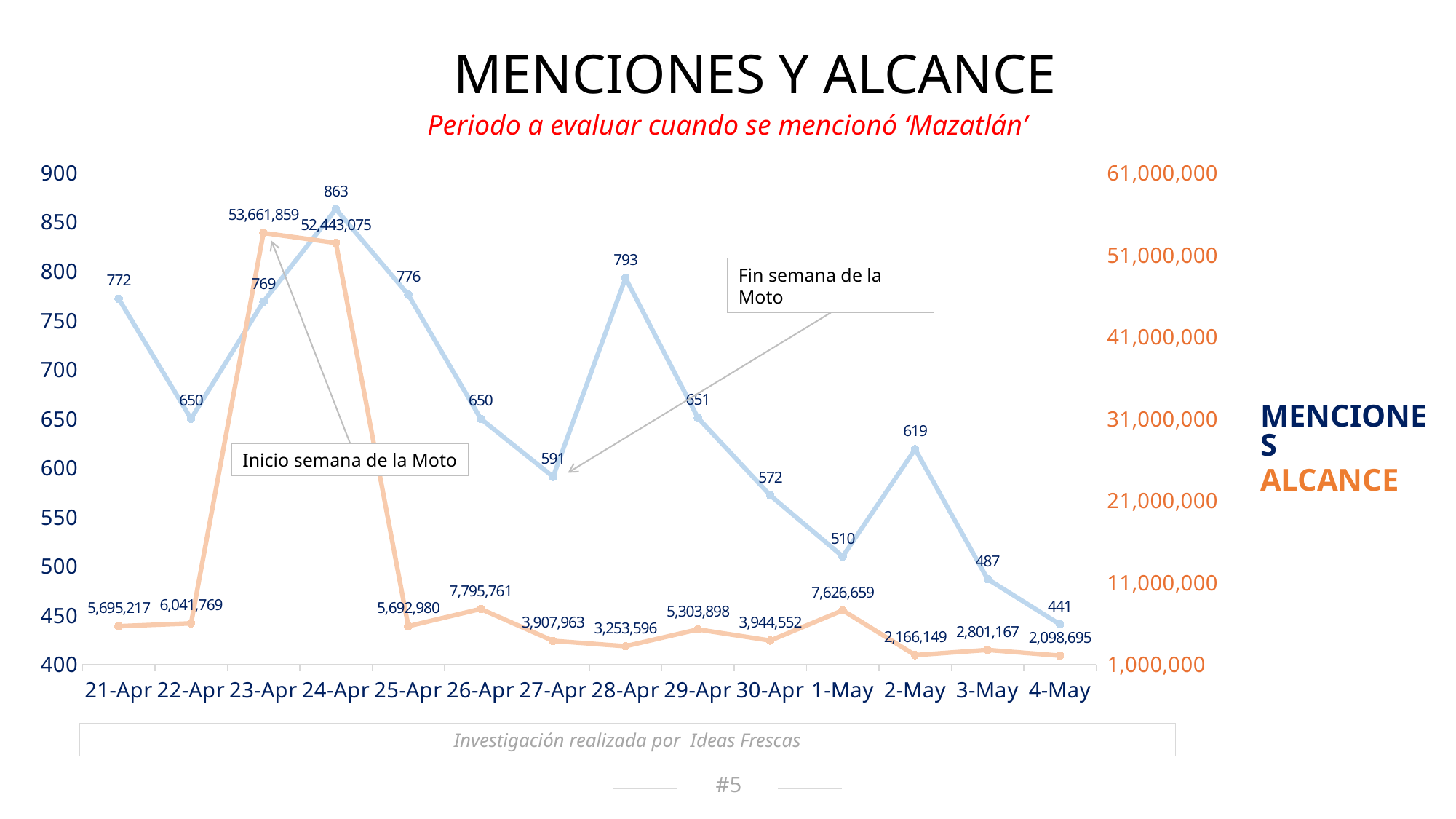
What is the title of the chart? MENCIONES Y ALCANCE How many dates are plotted along the x axis? 14 What is the ALCANCE value on 4-May? 2,098,695 On which date is ALCANCE highest? 23-Apr Is the MENCIONES value on 1-May greater or less than 550? less Which is larger, the MENCIONES value on 28-Apr or on 25-Apr? 28-Apr What is the MENCIONES value on 24-Apr? 863 What is the difference between the MENCIONES values on 24-Apr and 4-May? 422 What type of chart is shown on the slide? Line chart How many series does the legend list? 2 On which date is MENCIONES lowest? 4-May What is the ALCANCE value on 23-Apr? 53,661,859